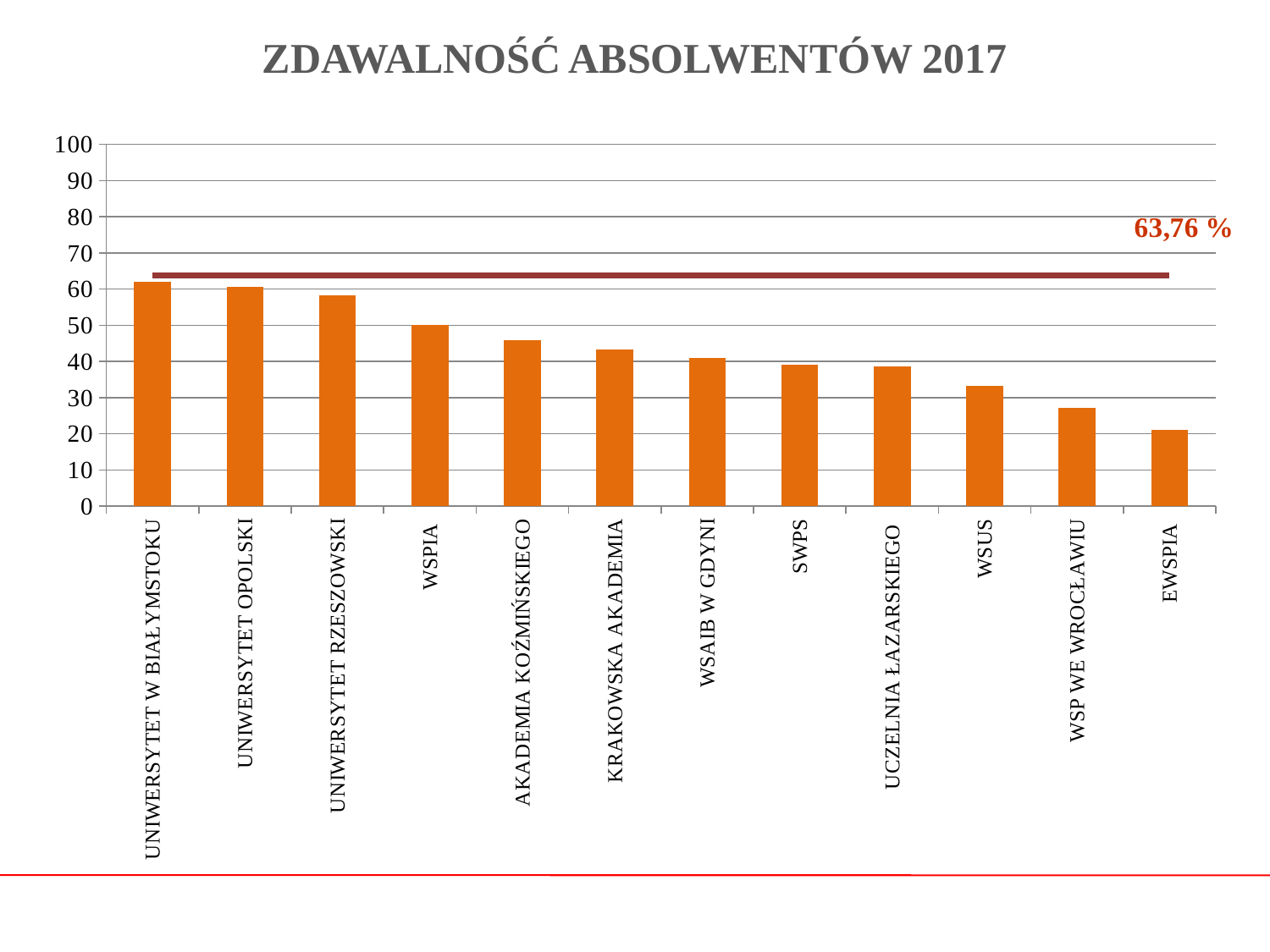
Which university has the lowest bar? EWSPIA Which is larger, the value for WSPIA or the value for SWPS? WSPIA Is the value for WSUS greater or less than 40? less Is the value for EWSPIA greater or less than 30? less Which is larger, the value for WSP WE WROCŁAWIU or the value for KRAKOWSKA AKADEMIA? KRAKOWSKA AKADEMIA Which university has the highest bar? UNIWERSYTET W BIAŁYMSTOKU What kind of chart is shown on the slide? bar chart What value is printed next to the horizontal reference line? 63,76 % How many universities (bars) are shown in the chart? 12 Do the bar values rise or fall from left to right along the x axis? fall Is the value for UNIWERSYTET RZESZOWSKI greater or less than 50? greater What is the title of the chart? ZDAWALNOŚĆ ABSOLWENTÓW 2017